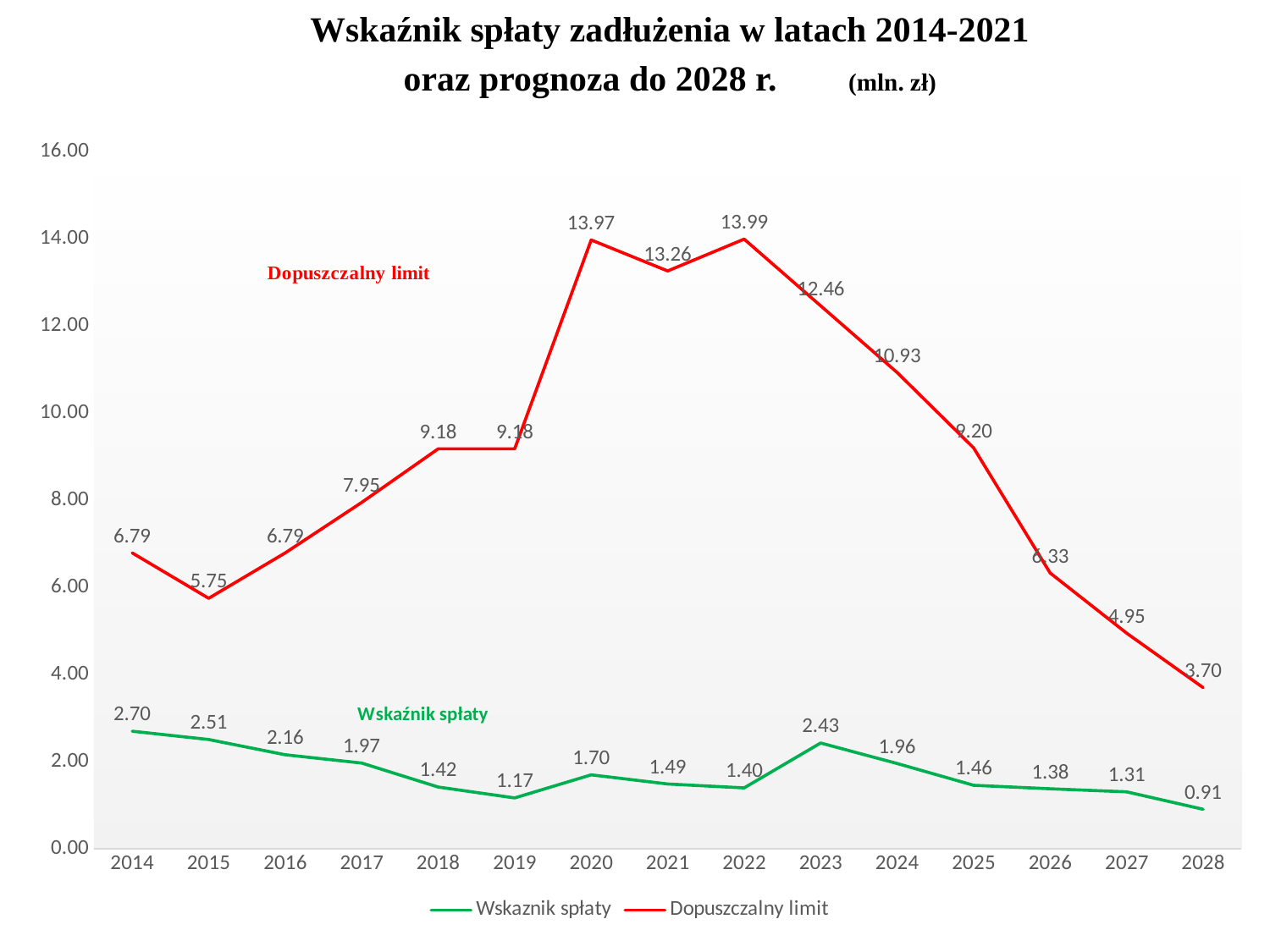
How many years are plotted along the x axis? 15 What is the value of Dopuszczalny limit in 2028? 3.70 What colour is the Dopuszczalny limit line? red How many series does the legend list? 2 What is the difference between Dopuszczalny limit and Wskaźnik spłaty in 2022? 12.59 Which is larger: Dopuszczalny limit in 2017 or Dopuszczalny limit in 2026? Dopuszczalny limit in 2017 In which year is Wskaźnik spłaty at its highest? 2014 What type of chart is shown on the slide? line chart Does Dopuszczalny limit rise or fall from 2022 to 2028? fall In which year is Dopuszczalny limit at its lowest? 2028 What is the value of Dopuszczalny limit in 2020? 13.97 What is the value of Wskaźnik spłaty in 2023? 2.43